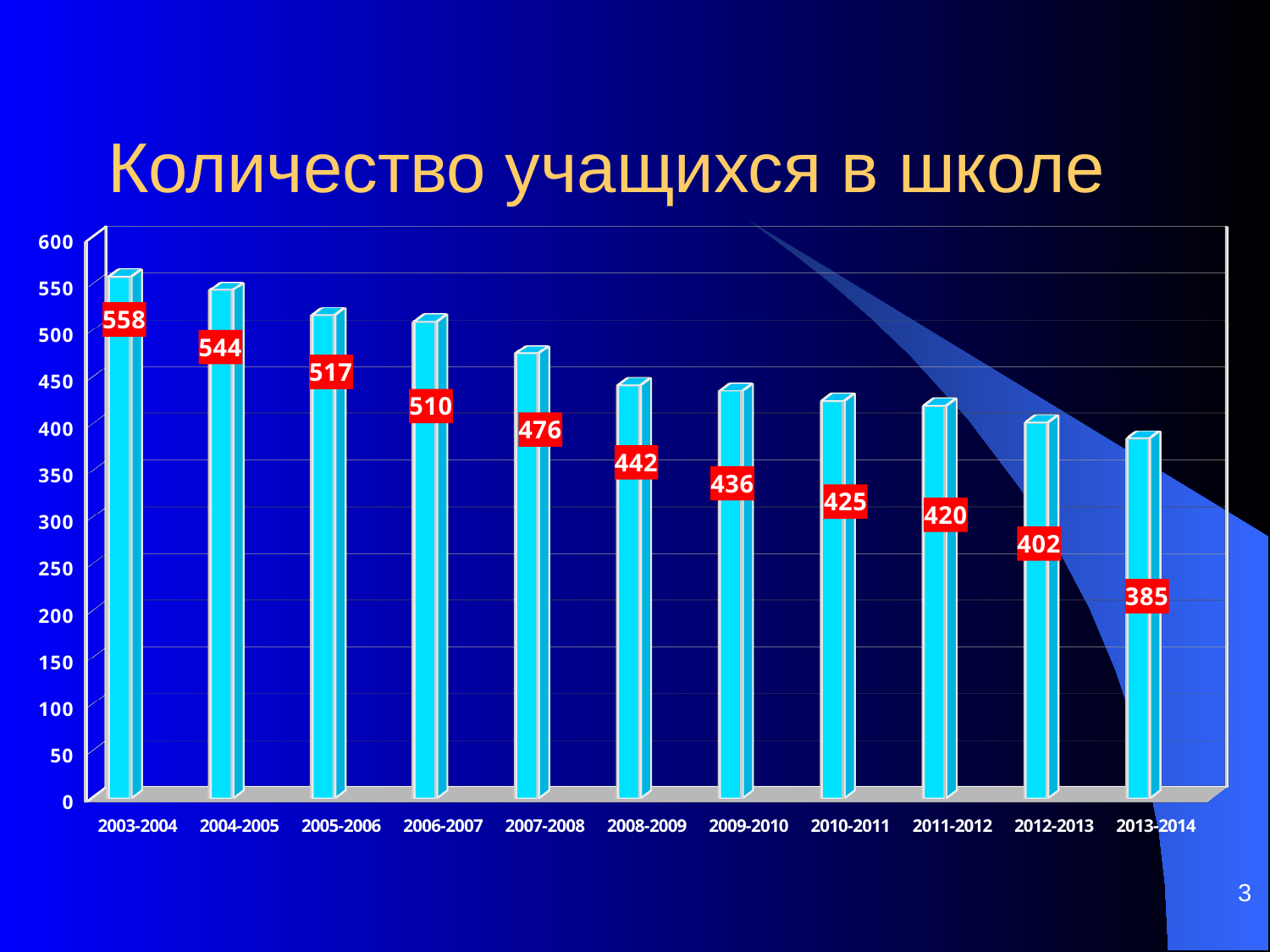
Which is larger, the value for 2005-2006 or the value for 2008-2009? 2005-2006 What is the difference between the values for 2003-2004 and 2013-2014? 173 How many school years are shown on the x axis? 11 Which school year has the lowest number of students? 2013-2014 Do the values rise or fall from 2003-2004 to 2013-2014? fall Is the value for 2012-2013 greater or less than 450? less What kind of chart is shown on the slide? bar chart What is the difference between the values for 2006-2007 and 2007-2008? 34 Which school year has the highest number of students? 2003-2004 What is the number of students for 2003-2004? 558 What is the number of students for 2009-2010? 436 What is the number of students for 2013-2014? 385